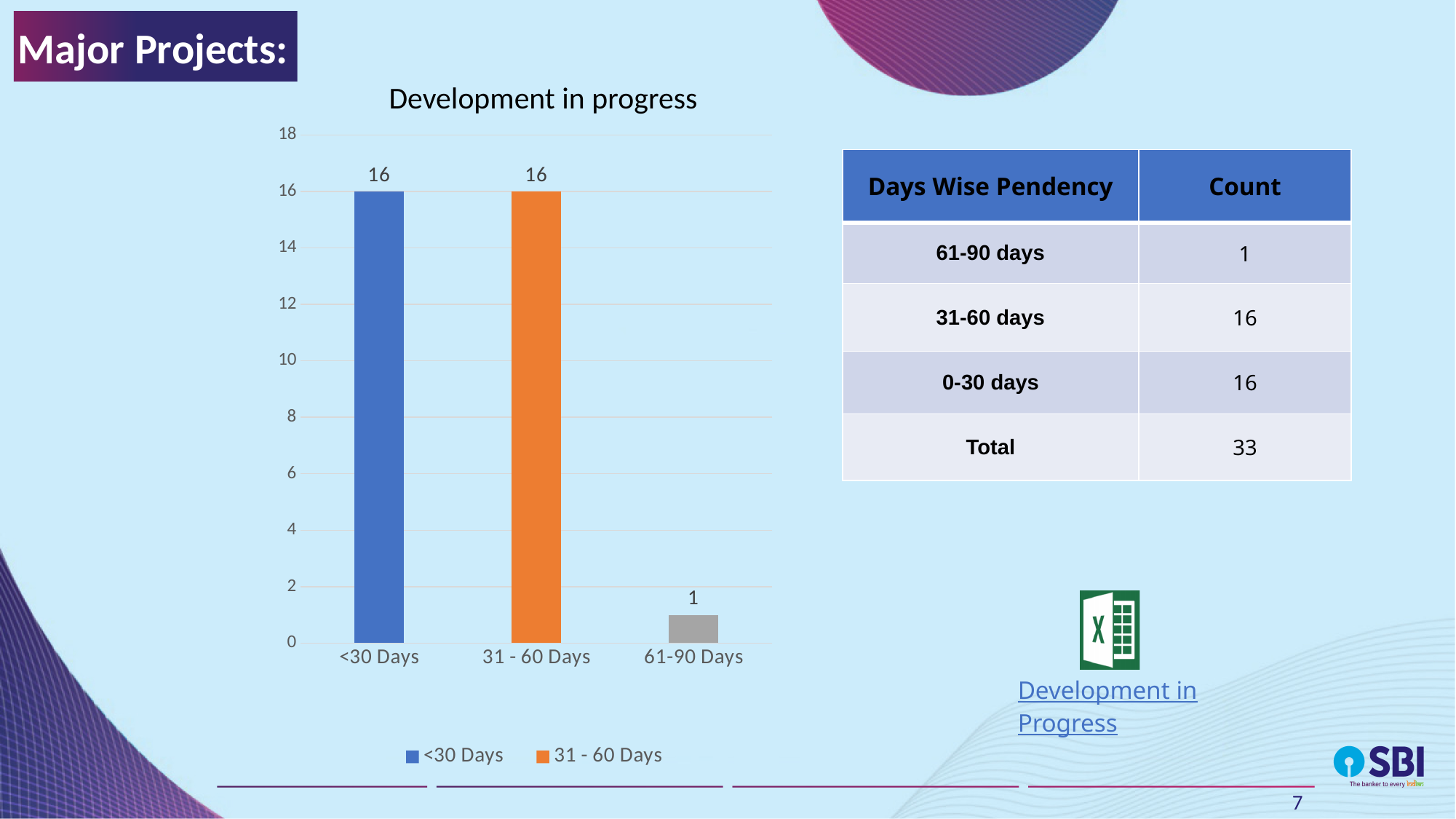
What is the difference between the values for <30 Days and 61-90 Days in the Development in progress chart? 15 What is the value for 31 - 60 Days in the Development in progress chart? 16 What is the value for 61-90 Days in the Development in progress chart? 1 Is the value for 61-90 Days in the Development in progress chart greater or less than 2? less How many categories are shown on the x axis of the Development in progress chart? 3 Which category has the lowest value in the Development in progress chart? 61-90 Days How many entries does the legend of the Development in progress chart list? 2 What kind of chart is the Development in progress chart? bar chart Is the value for <30 Days in the Development in progress chart greater or less than 10? greater What is the value for <30 Days in the Development in progress chart? 16 What is the title of the chart on the slide? Development in progress Which is larger in the Development in progress chart, the value for 31 - 60 Days or the value for 61-90 Days? 31 - 60 Days